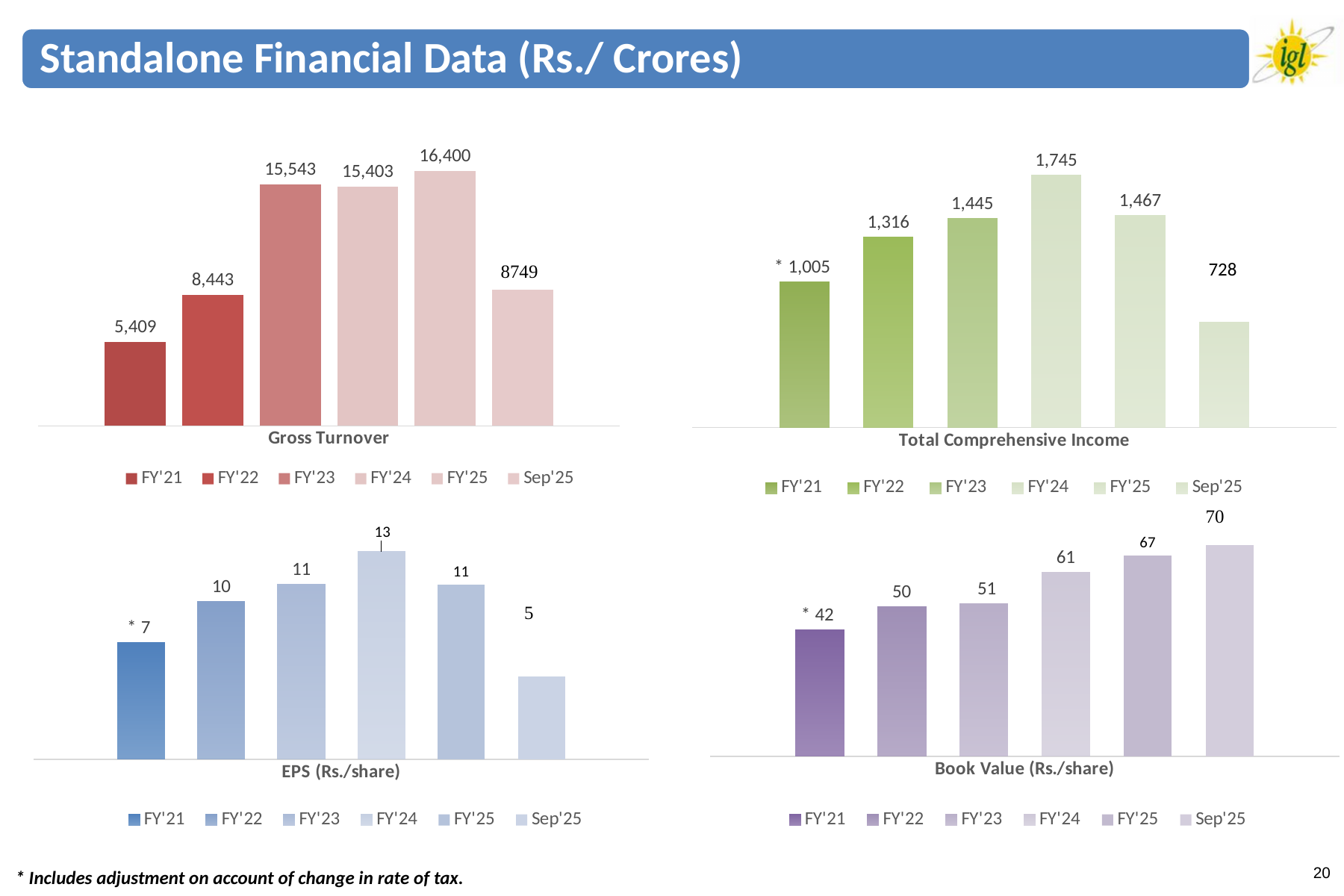
In the Gross Turnover chart, what is the value for FY'25? 16,400 In the Total Comprehensive Income chart, which period has the highest value? FY'24 In the Total Comprehensive Income chart, is the value for FY'23 or FY'25 larger? FY'25 How many periods are shown in the Gross Turnover chart? 6 In the Book Value (Rs./share) chart, what is the value for FY'21? 42 In the Gross Turnover chart, what is the difference between FY'23 and FY'24? 140 In the Book Value (Rs./share) chart, do the values rise or fall from FY'21 to Sep'25? rise In the Gross Turnover chart, which period has the lowest value? FY'21 In the Total Comprehensive Income chart, what is the value for FY'24? 1,745 In the EPS (Rs./share) chart, what is the value for FY'24? 13 In the EPS (Rs./share) chart, what is the value for Sep'25? 5 In the Book Value (Rs./share) chart, what is the difference between Sep'25 and FY'25? 3